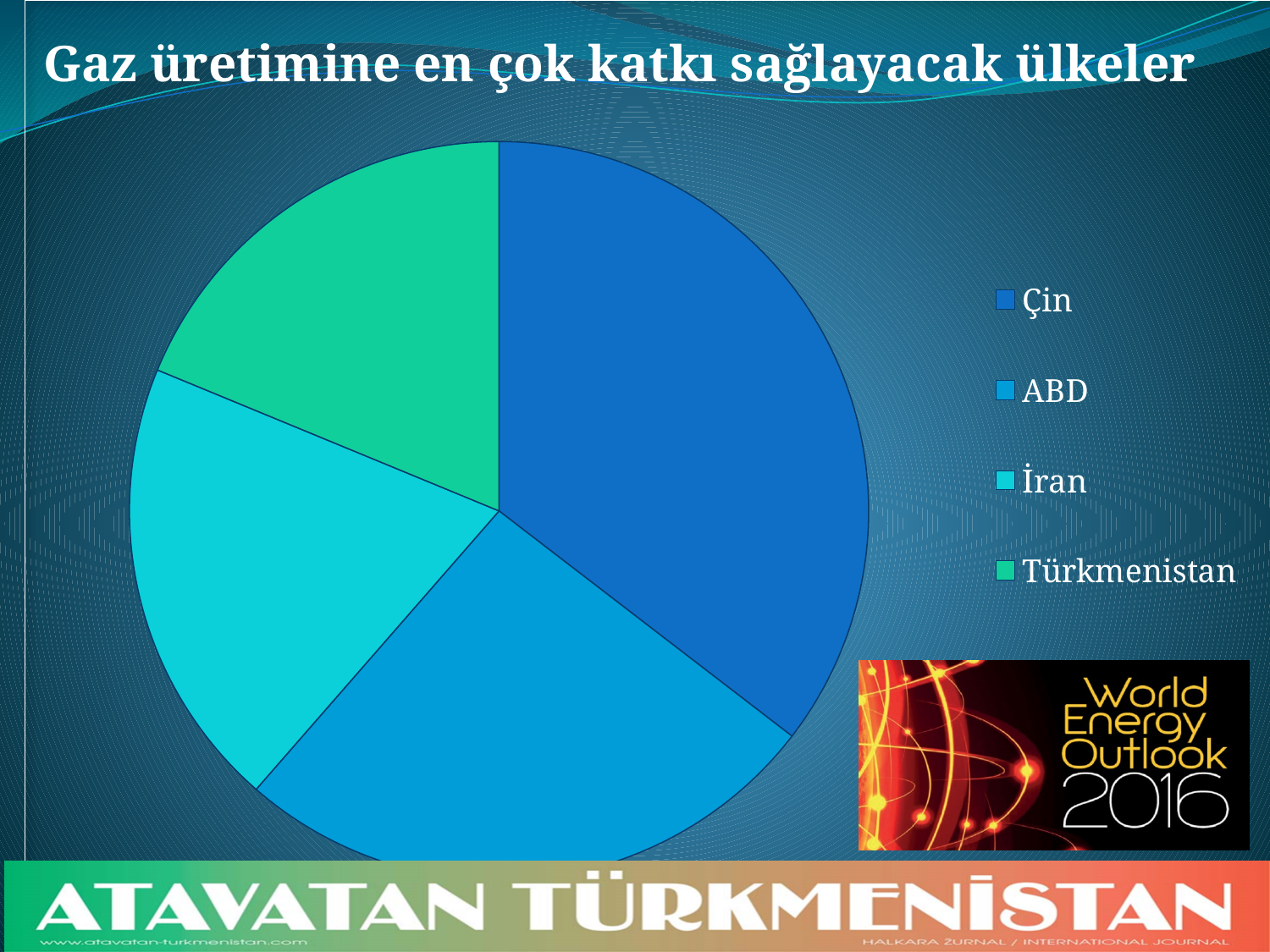
Which slice is larger, Çin or ABD? Çin How many slices does the pie chart have? 4 How many entries does the legend list? 4 Which country has the largest slice of the pie chart? Çin Which slice is larger, Çin or İran? Çin Which slice is larger, ABD or Türkmenistan? ABD Which country is shown in green in the pie chart? Türkmenistan What kind of chart is shown on the slide? pie chart What is the title of the chart on the slide? Gaz üretimine en çok katkı sağlayacak ülkeler